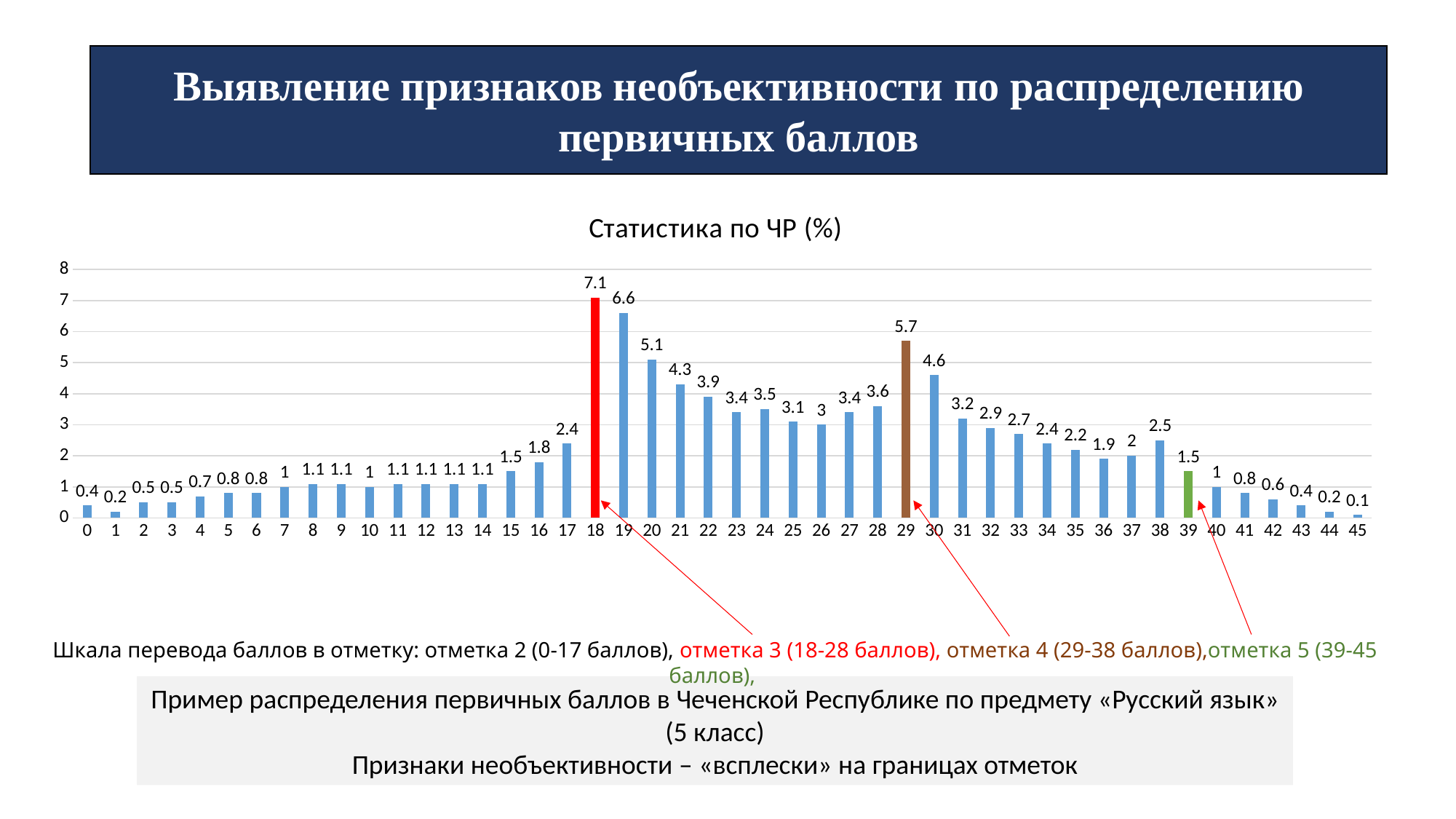
How many score categories are shown on the x axis of the chart? 46 What kind of chart is shown on the slide? bar chart What is the difference between the values for score 18 and score 19? 0.5 What is the value for score 19 in the chart? 6.6 Which score has the lowest value in the chart? 45 What is the value for score 18 in the chart? 7.1 Which is larger, the value for score 20 or the value for score 29? 29 Which score has the highest value in the chart? 18 What is the difference between the values for score 29 and score 30? 1.1 What is the title of the chart? Статистика по ЧР (%) What is the value for score 39 in the chart? 1.5 What is the value for score 29 in the chart? 5.7